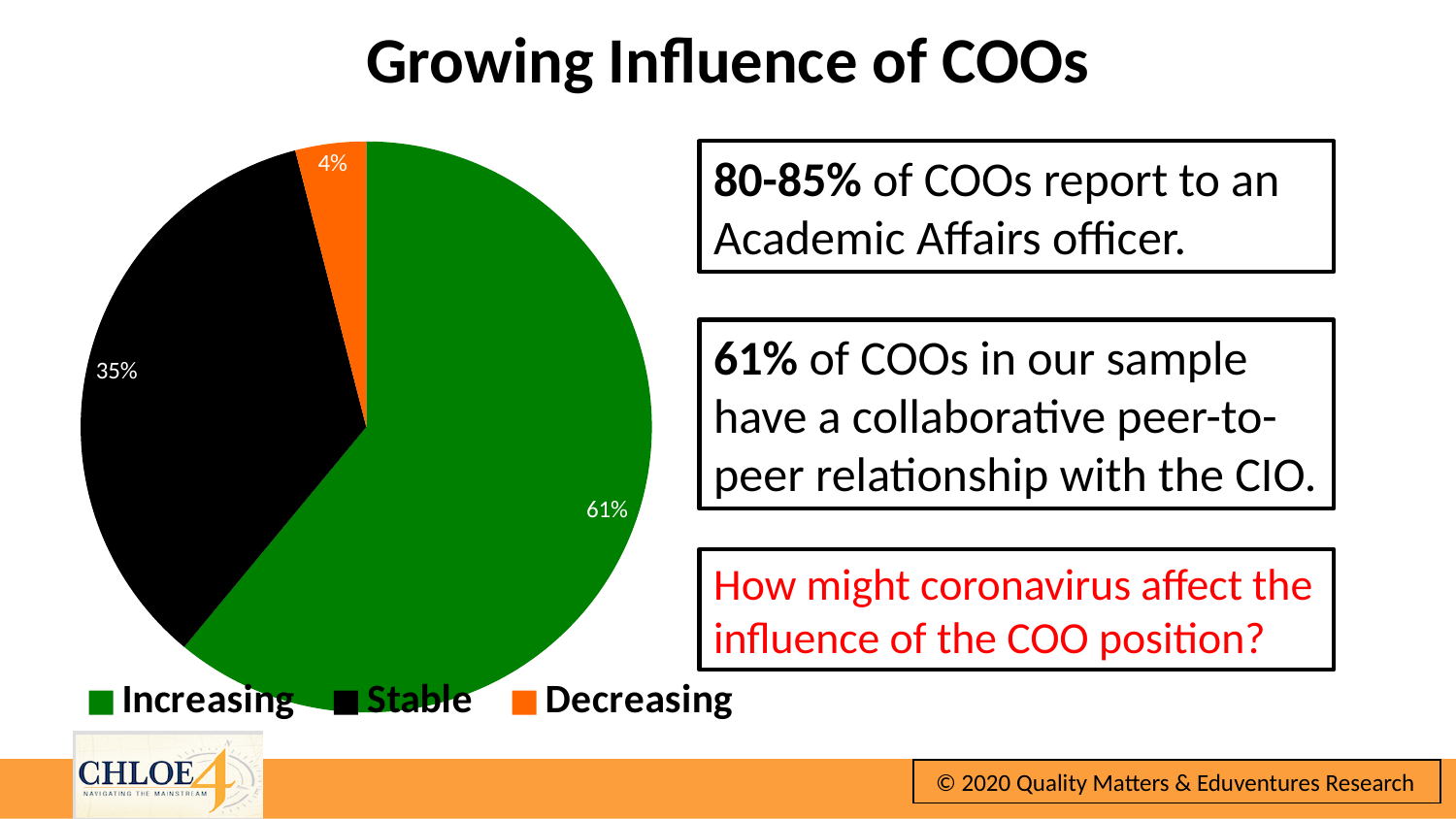
What kind of chart is shown on the slide? pie chart What is the difference in percentage points between the Increasing and Stable slices? 26 Which category has the largest slice of the pie? Increasing What share of the pie is labelled Stable? 35% What share of the pie is labelled Increasing? 61% How many categories does the legend list? 3 Which category has the smallest slice of the pie? Decreasing What is the difference in percentage points between the Stable and Decreasing slices? 31 What is the title of the slide containing the pie chart? Growing Influence of COOs Which is larger, the Stable slice or the Decreasing slice? Stable What share of the pie is labelled Decreasing? 4% What colour is the Decreasing slice? orange